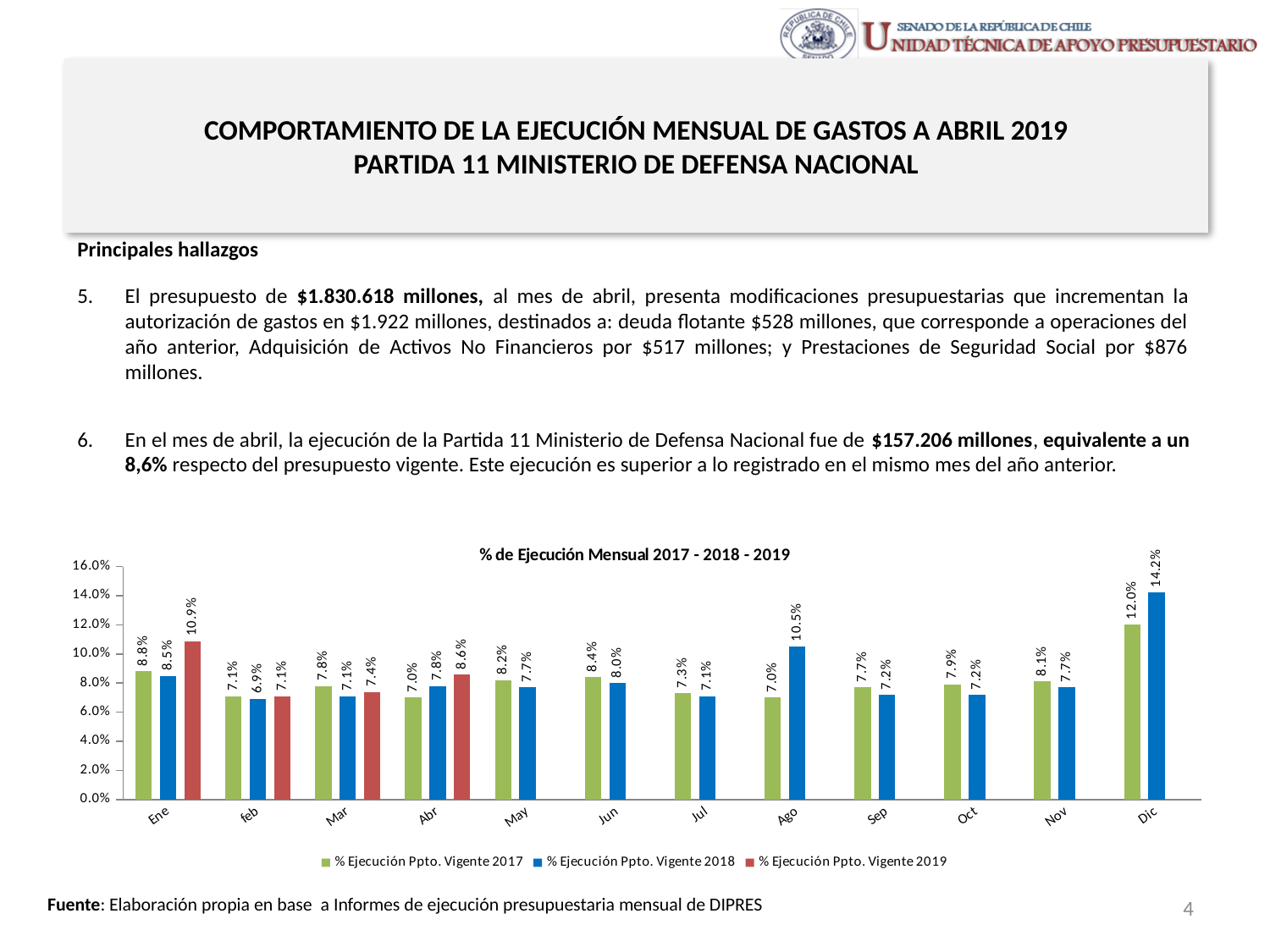
What is the value for % Ejecución Ppto. Vigente 2017 in Dic? 12.0% Which month has the lowest value for % Ejecución Ppto. Vigente 2018? feb What is the value for % Ejecución Ppto. Vigente 2018 in Ago? 10.5% How many months are shown on the x axis of the chart? 12 What is the title of the chart? % de Ejecución Mensual 2017 - 2018 - 2019 In Ene, which series has the larger value: % Ejecución Ppto. Vigente 2019 or % Ejecución Ppto. Vigente 2017? % Ejecución Ppto. Vigente 2019 Is the value for % Ejecución Ppto. Vigente 2018 in Dic greater or less than 12.0%? greater What is the value for % Ejecución Ppto. Vigente 2019 in Abr? 8.6% What kind of chart is shown on the slide? Bar chart How many series does the chart legend list? 3 What is the difference between the 2018 and 2017 values in Dic? 2.2% Which month has the highest value for % Ejecución Ppto. Vigente 2018? Dic